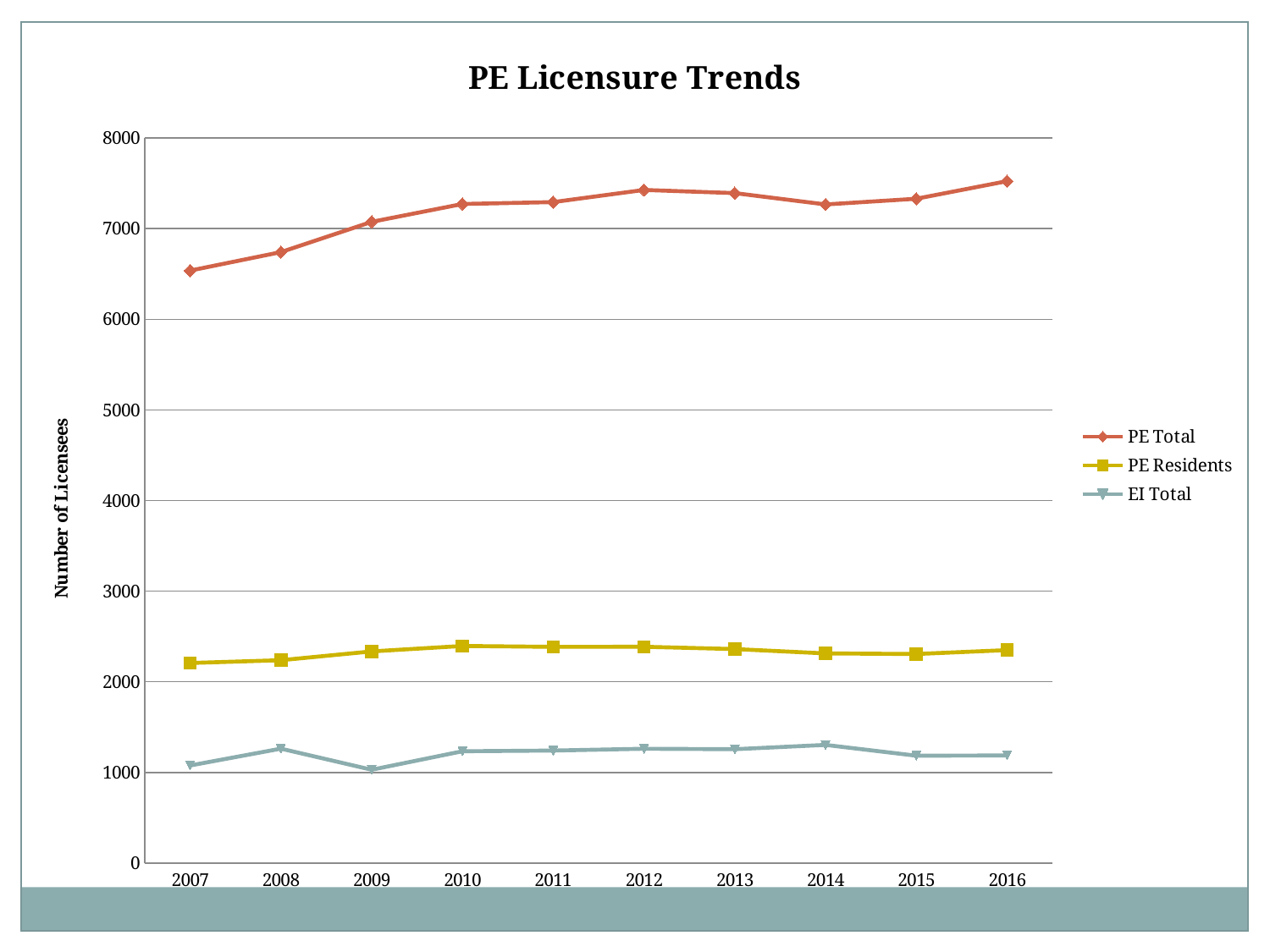
In which year is PE Total at its highest? 2016 What kind of chart is shown on the slide? line chart Is the value for EI Total in 2014 greater or less than 2000? less Is the value for PE Total in 2016 greater or less than 7000? greater Is the value for PE Residents in 2010 greater or less than 2000? greater Does the PE Total line rise or fall from 2007 to 2010? rise What is the label on the vertical axis? Number of Licensees How many series does the legend list? 3 Which series has the larger value in 2012, PE Residents or EI Total? PE Residents In which year is PE Total at its lowest? 2007 How many years are plotted along the x axis? 10